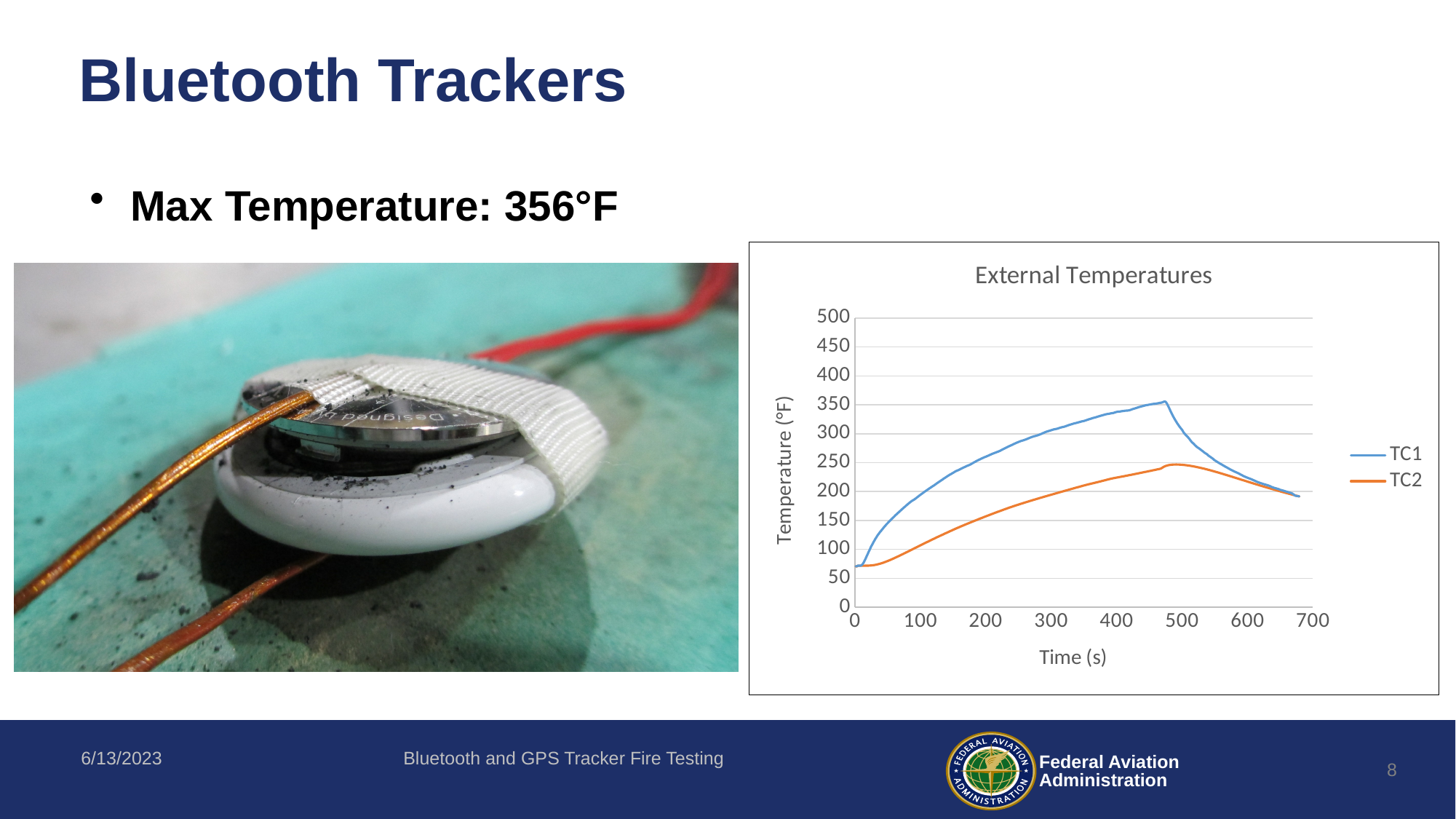
Is the peak value of TC2 greater or less than 300? less At 200 s, which series has the higher temperature, TC1 or TC2? TC1 How many series does the legend of the External Temperatures chart list? 2 Which series stays lower throughout most of the test, TC1 or TC2? TC2 Is the peak value of TC1 greater or less than 300? greater Does the TC1 temperature rise or fall between 0 s and 400 s? rise What is the title of the chart on the slide? External Temperatures What kind of chart is shown on the slide? line chart Is the value of TC2 at 300 s greater or less than 250? less Which series reaches the higher peak temperature, TC1 or TC2? TC1 What are the two series named in the chart legend? TC1 and TC2